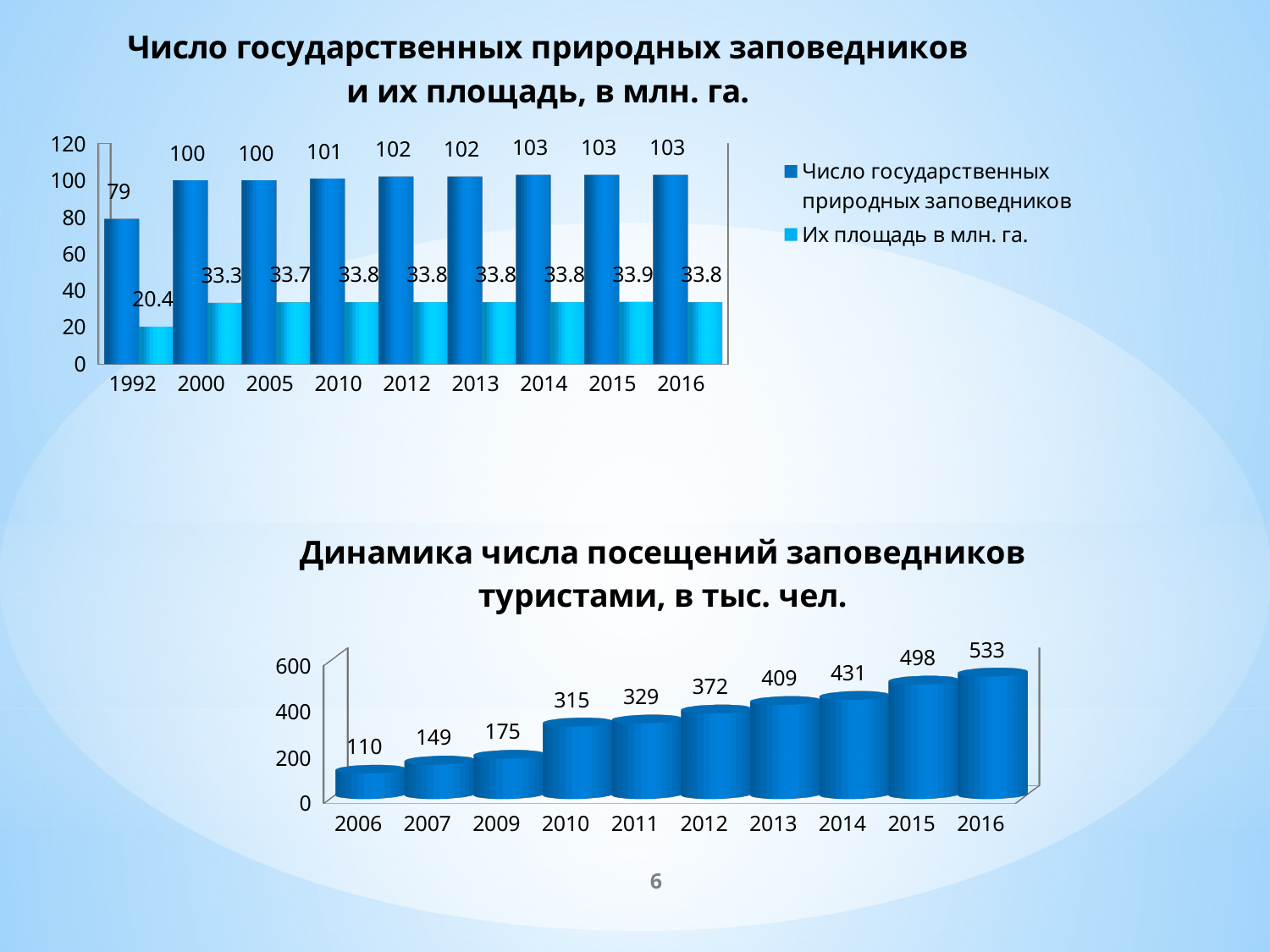
In the bottom chart, which year has the highest number of tourist visits? 2016 In the top chart 'Число государственных природных заповедников и их площадь, в млн. га.', what is the number of state nature reserves in 1992? 79 In the top chart, what is the area of the reserves in million hectares in 2015? 33.9 In the top chart, is the area of reserves in 2000 greater or less than 40? less In the top chart, what is the difference between the number of reserves in 2016 and in 1992? 24 In the bottom chart, do the values rise or fall from 2006 to 2016? rise In the top chart, which year has the lowest number of state nature reserves? 1992 What kind of chart is the bottom chart? bar chart In the top chart, how many years are shown on the x axis? 9 In the top chart, how many series does the legend list? 2 In the bottom chart 'Динамика числа посещений заповедников туристами, в тыс. чел.', what is the number of visits in 2012? 372 In the bottom chart, what is the difference between the visits in 2016 and in 2006? 423